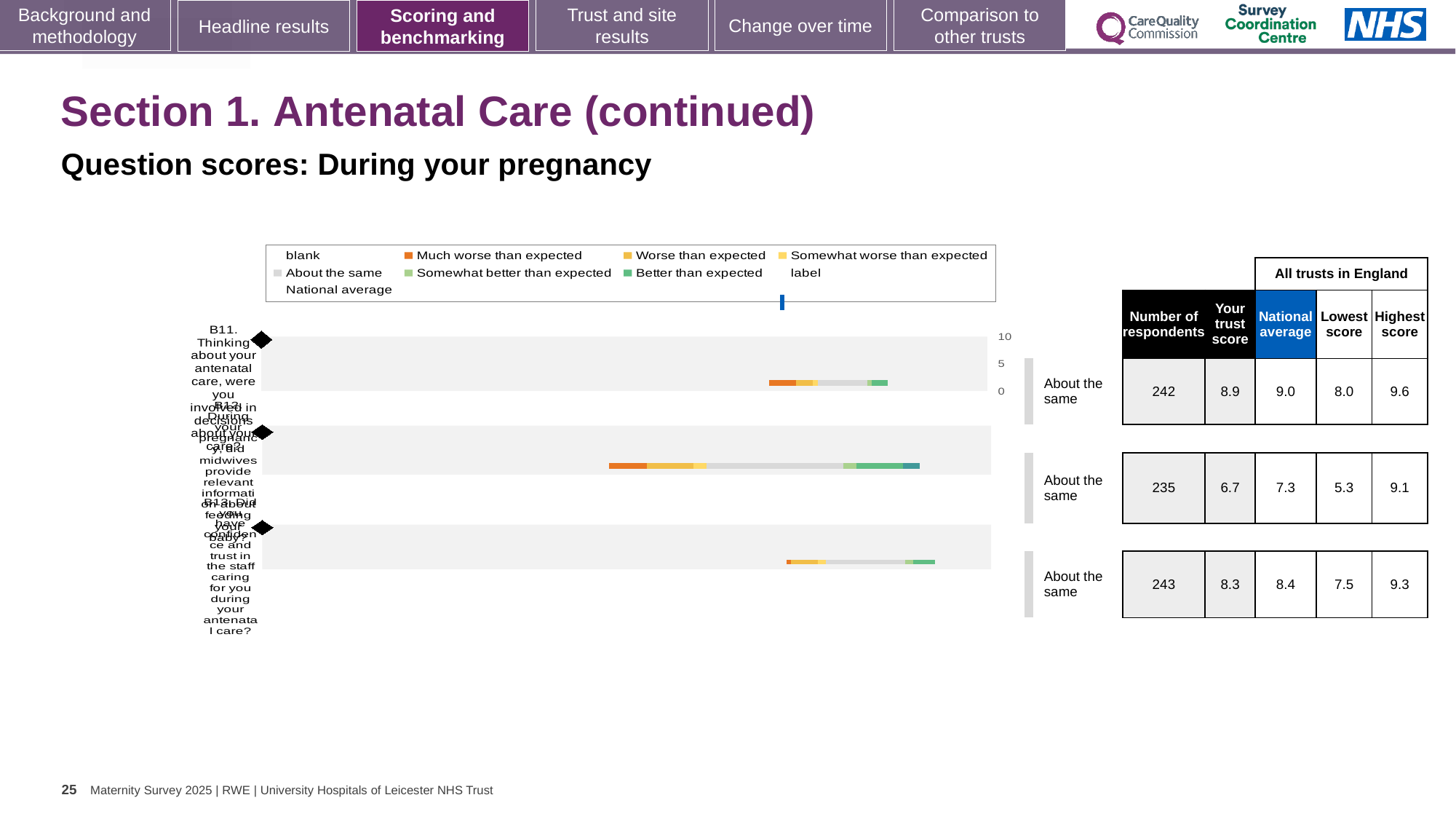
What is 'Your trust score' for the first (top) row, B11, in the table beside the chart? 8.9 Which row has the lowest national average in the table beside the chart? the second (middle) row Is 'Your trust score' larger for the first (top) row or the third (bottom) row? the first (top) row What kind of chart is shown on the slide? bar chart Which row has the highest 'Your trust score' in the table beside the chart? the first (top) row, B11 What is the number of respondents for the second (middle) row in the table beside the chart? 235 For the second (middle) row, what is the difference between the highest score and the lowest score across all trusts in England? 3.8 What benchmark category is shown next to each of the three bars in the chart? About the same What is the highest score across all trusts in England for the third (bottom) row in the table beside the chart? 9.3 How many question rows (bars) does the chart show? 3 In the chart legend, what colour represents 'Much worse than expected'? orange For the second (middle) row, how much higher is the national average than 'Your trust score'? 0.6